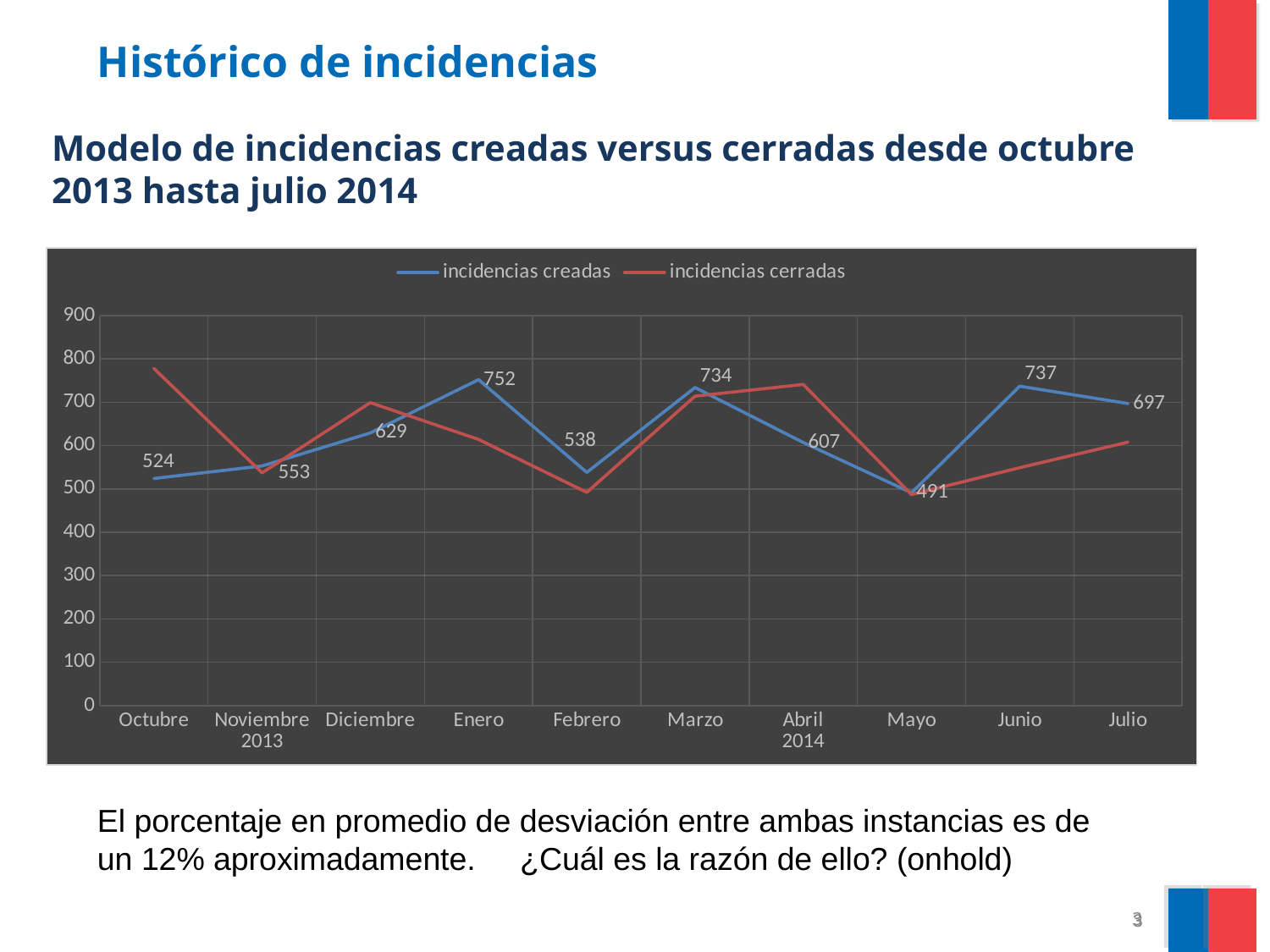
In which month is incidencias creadas lowest? Mayo What kind of chart is shown on the slide? Line chart In which month is incidencias creadas highest? Enero What is the value of incidencias creadas in Octubre? 524 What is the value of incidencias creadas in Mayo? 491 How many months are shown on the x axis? 10 What is the difference between incidencias creadas in Enero and in Mayo? 261 Is the value of incidencias cerradas in Octubre greater or less than 700? greater How many series does the legend list? 2 What is the value of incidencias creadas in Enero? 752 Is the value of incidencias cerradas in Febrero greater or less than 600? less Which is larger for incidencias creadas: Diciembre or Abril? Diciembre